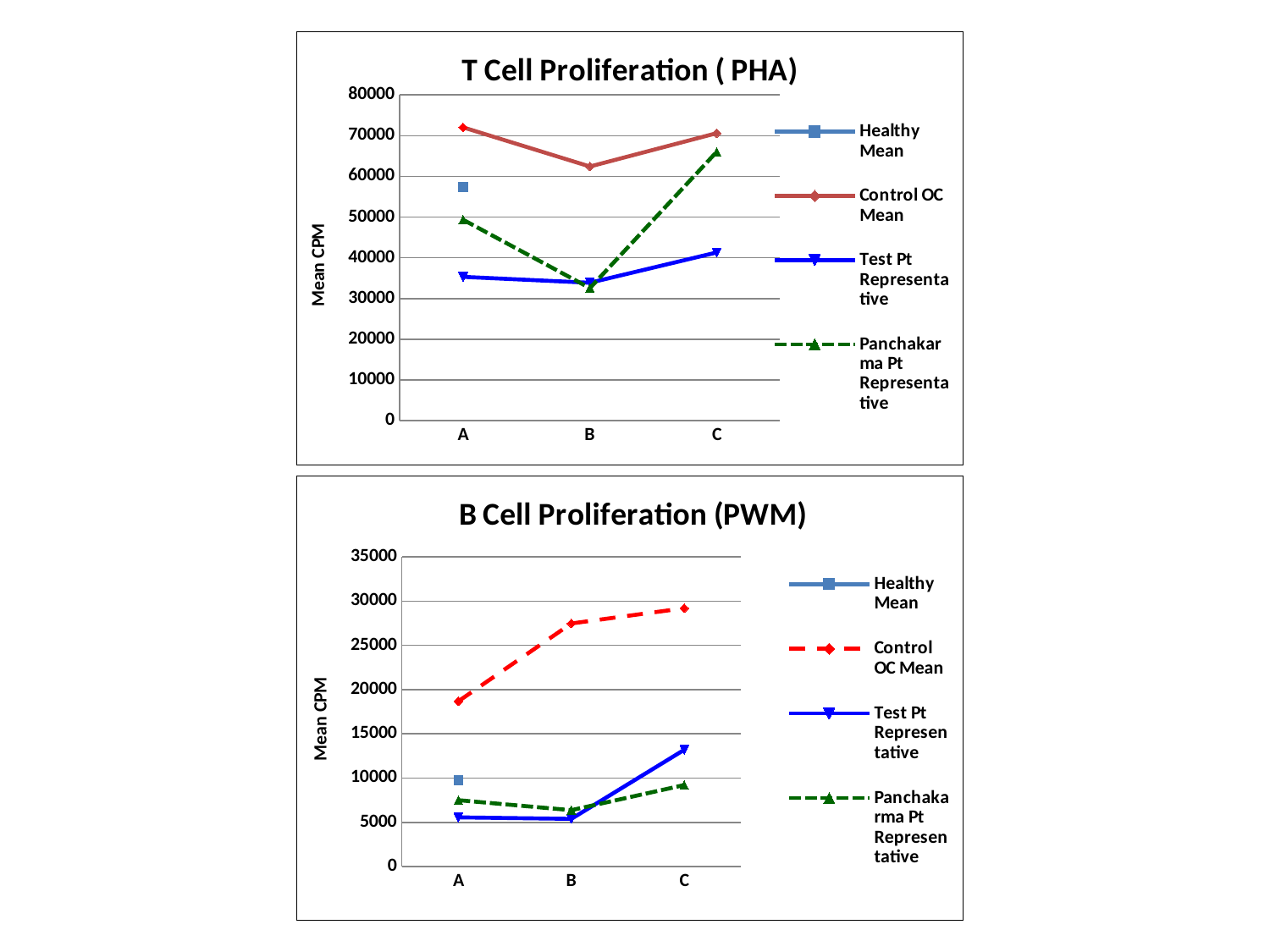
In the "T Cell Proliferation ( PHA)" chart, does the Control OC Mean line rise or fall from A to B? fall How many categories are shown on the x axis of the "T Cell Proliferation ( PHA)" chart? 3 In the "T Cell Proliferation ( PHA)" chart, is the value for Test Pt Representative at B greater or less than 40000? less In the "B Cell Proliferation (PWM)" chart, does the Control OC Mean line rise or fall from A to C? rise In the "T Cell Proliferation ( PHA)" chart, is the value for Control OC Mean at A greater or less than 60000? greater What kind of chart is the "B Cell Proliferation (PWM)" chart? line chart In the "T Cell Proliferation ( PHA)" chart, which is larger at C: Control OC Mean or Test Pt Representative? Control OC Mean What is the y-axis label of the "B Cell Proliferation (PWM)" chart? Mean CPM What kind of chart is the "T Cell Proliferation ( PHA)" chart? line chart In the "T Cell Proliferation ( PHA)" chart, at which category is Panchakarma Pt Representative highest? C How many series does the legend of the "T Cell Proliferation ( PHA)" chart list? 4 In the "B Cell Proliferation (PWM)" chart, is the value for Control OC Mean at C greater or less than 25000? greater